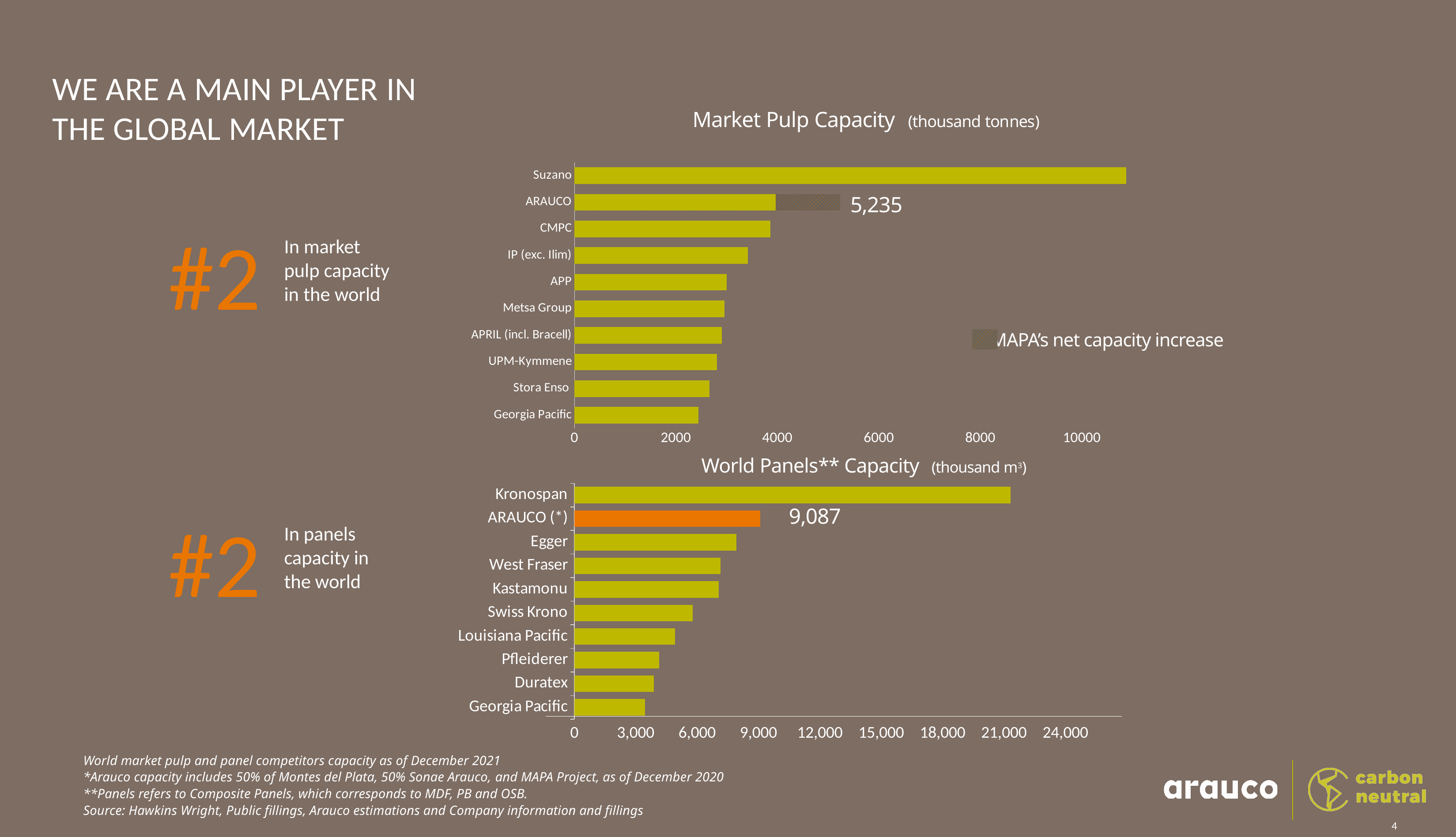
In the Market Pulp Capacity chart, is the value for Suzano greater or less than 10000? greater What kind of chart is the World Panels Capacity chart? Bar chart How many companies are shown in the Market Pulp Capacity chart? 10 In the Market Pulp Capacity chart, what does the hatched segment on the ARAUCO bar represent? MAPA's net capacity increase In the World Panels Capacity chart, is the value for Egger greater or less than 9,000? less In the World Panels Capacity chart, which company has the lowest capacity? Georgia Pacific In the World Panels Capacity chart, which company has the highest capacity? Kronospan In the World Panels Capacity chart, which is larger, Egger or Swiss Krono? Egger In the Market Pulp Capacity chart, which company has the lowest capacity? Georgia Pacific In the Market Pulp Capacity chart, which company has the highest capacity? Suzano In the Market Pulp Capacity chart, what is the value shown for ARAUCO? 5,235 In the World Panels Capacity chart, what is the value shown for ARAUCO (*)? 9,087